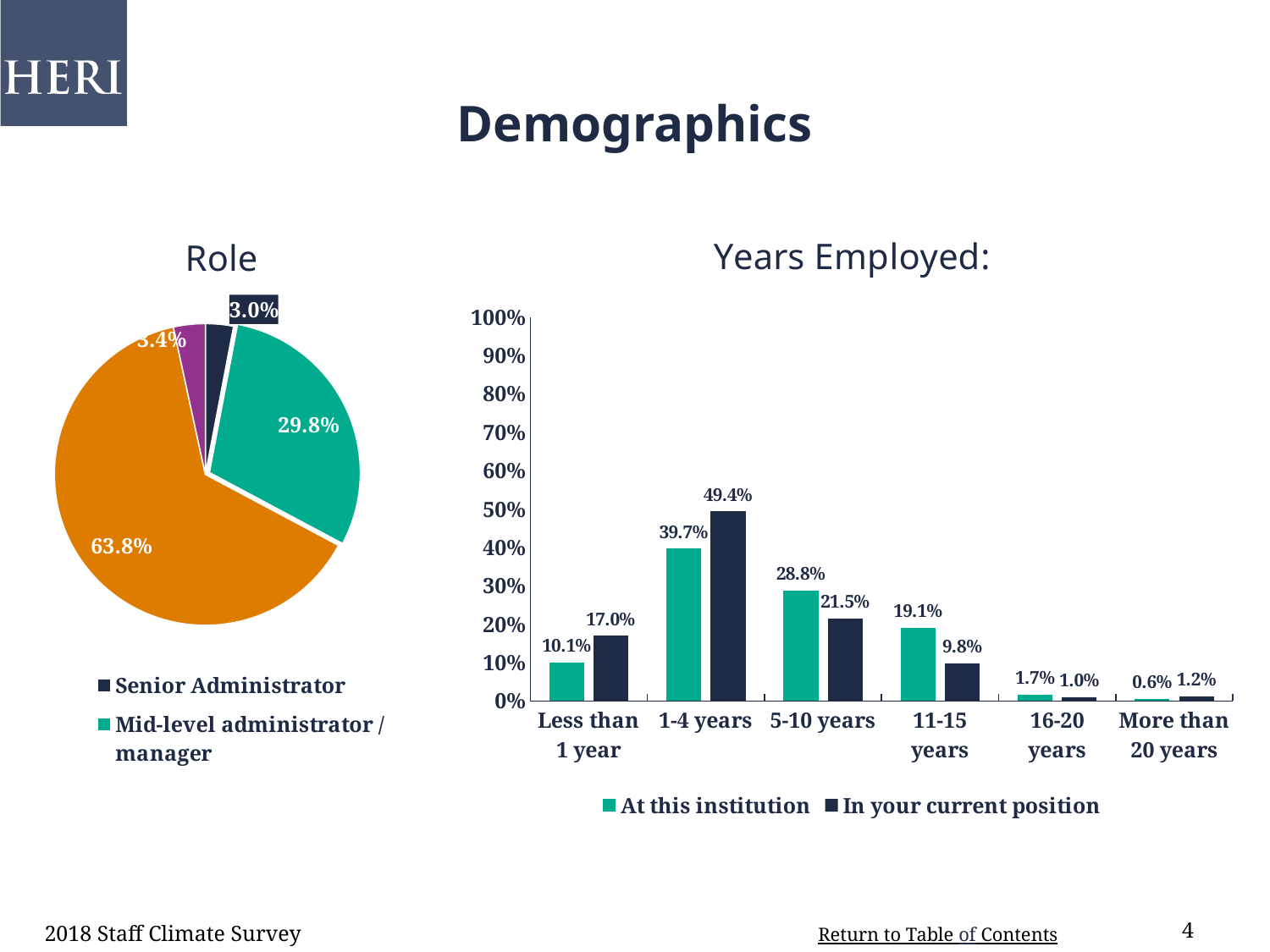
In the Years Employed chart, what is the value for 'At this institution' in the 1-4 years category? 39.7% In the Years Employed chart, how many series does the legend list? 2 In the Role chart, what percentage is shown for Mid-level administrator / manager? 29.8% In the Years Employed chart, which category has the lowest value for 'At this institution'? More than 20 years What kind of chart is the Role chart? pie chart In the Years Employed chart, what is the difference between 'In your current position' and 'At this institution' in the 1-4 years category? 9.7% In the Years Employed chart, which category has the highest value for 'In your current position'? 1-4 years In the Years Employed chart, what is the value for 'In your current position' in the 5-10 years category? 21.5% In the Role chart, what percentage is shown for Senior Administrator? 3.0% In the Years Employed chart, how many categories are shown on the x axis? 6 What kind of chart is the Years Employed chart? bar chart In the Years Employed chart, for the 5-10 years category, which series has the larger value? At this institution